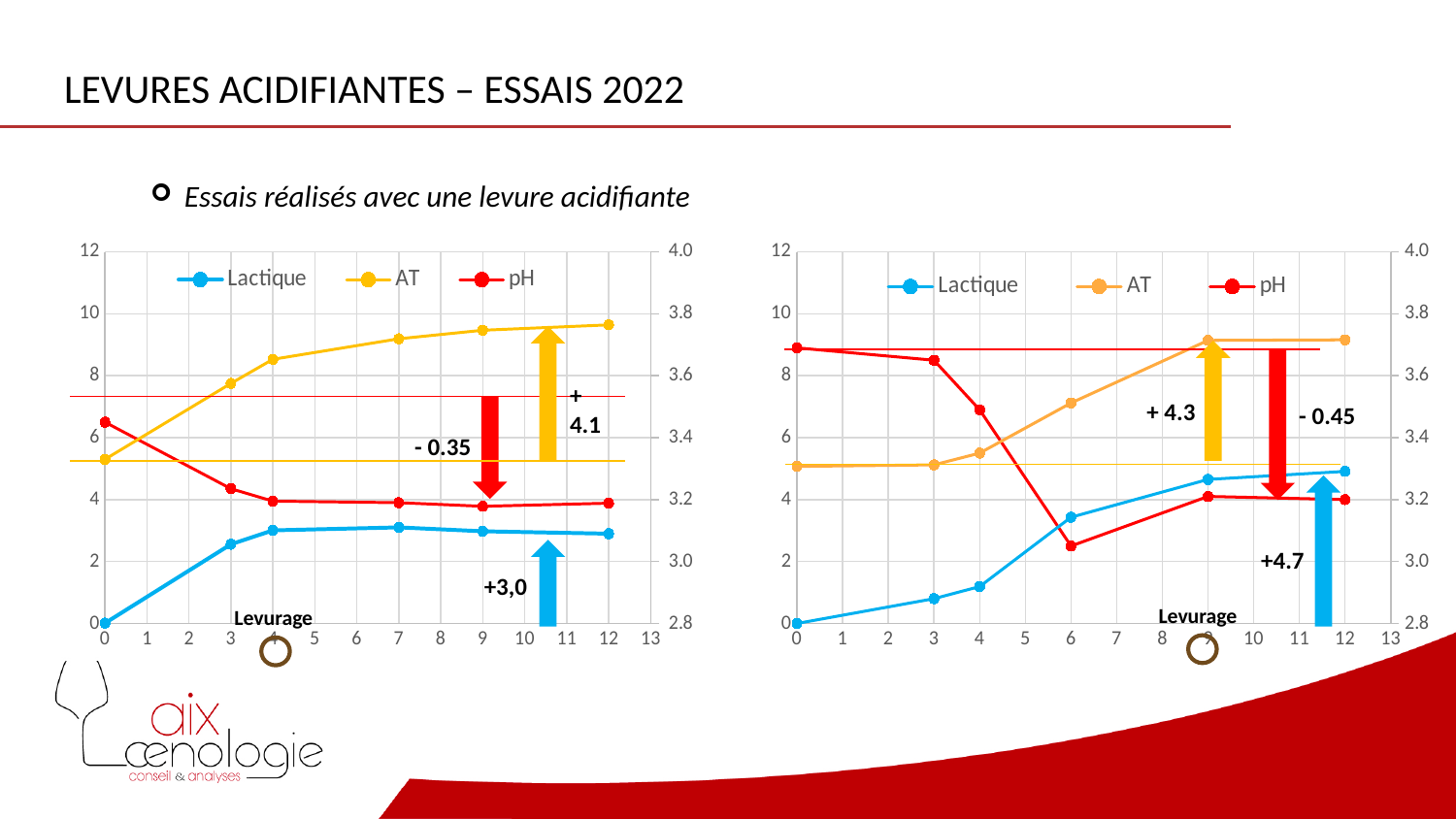
In the right chart, what change is annotated next to the red arrow for the pH series? - 0.45 In the left chart, which is larger at x = 12: the AT value or the Lactique value? AT In the right chart, is the Lactique value at x = 12 greater or less than 4? greater In the left chart, does the AT series rise or fall along the x axis? rise In the right chart, is the AT value at x = 0 greater or less than 6? less In the left chart, is the AT value at x = 12 greater or less than 8? greater In the left chart, what change is annotated next to the blue arrow for the Lactique series? +3,0 What kind of chart is the left chart? line chart In the right chart, does the pH series rise or fall along the x axis? fall How many series does the legend of the right chart list? 3 In the left chart, how many data points are plotted for the Lactique series? 6